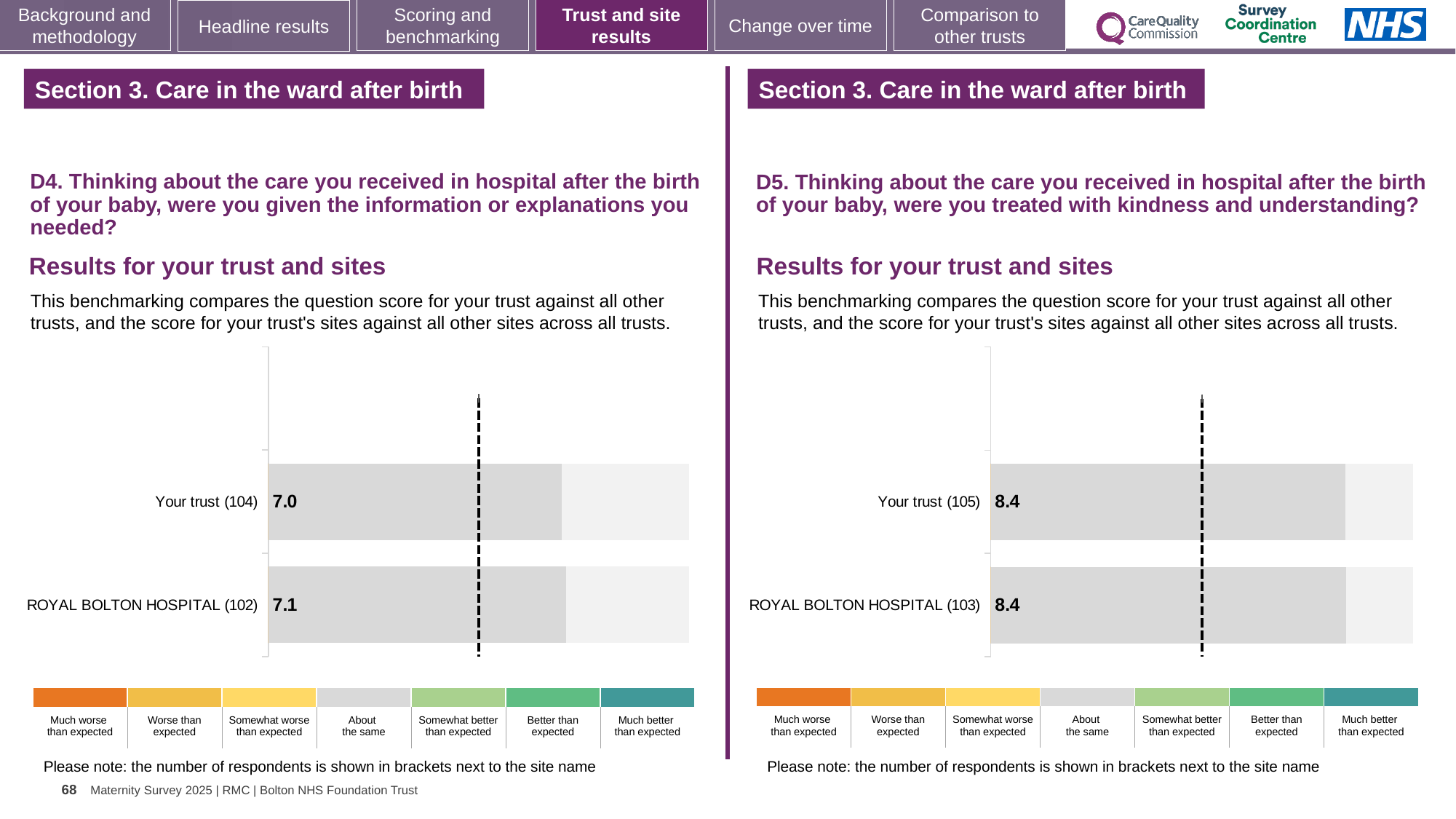
What type of chart is used for the D4 results on the left? Bar chart In the D4 chart on the left, what is the difference between the ROYAL BOLTON HOSPITAL score and the Your trust score? 0.1 In the D4 chart on the left, what is the score for ROYAL BOLTON HOSPITAL? 7.1 In the D4 chart on the left, how many respondents are shown in brackets for ROYAL BOLTON HOSPITAL? 102 How many bars are plotted in the D4 chart on the left? 2 In the D5 chart on the right, what is the score for ROYAL BOLTON HOSPITAL? 8.4 In the D5 chart on the right, what is the difference between the Your trust score and the ROYAL BOLTON HOSPITAL score? 0.0 In the D5 chart on the right, what is the score for Your trust? 8.4 In the D5 chart on the right, how many respondents are shown in brackets for Your trust? 105 Is the Your trust score in the D5 chart on the right larger or smaller than the Your trust score in the D4 chart on the left? Larger How many bars are plotted in the D5 chart on the right? 2 In the D4 chart on the left, what is the score for Your trust? 7.0